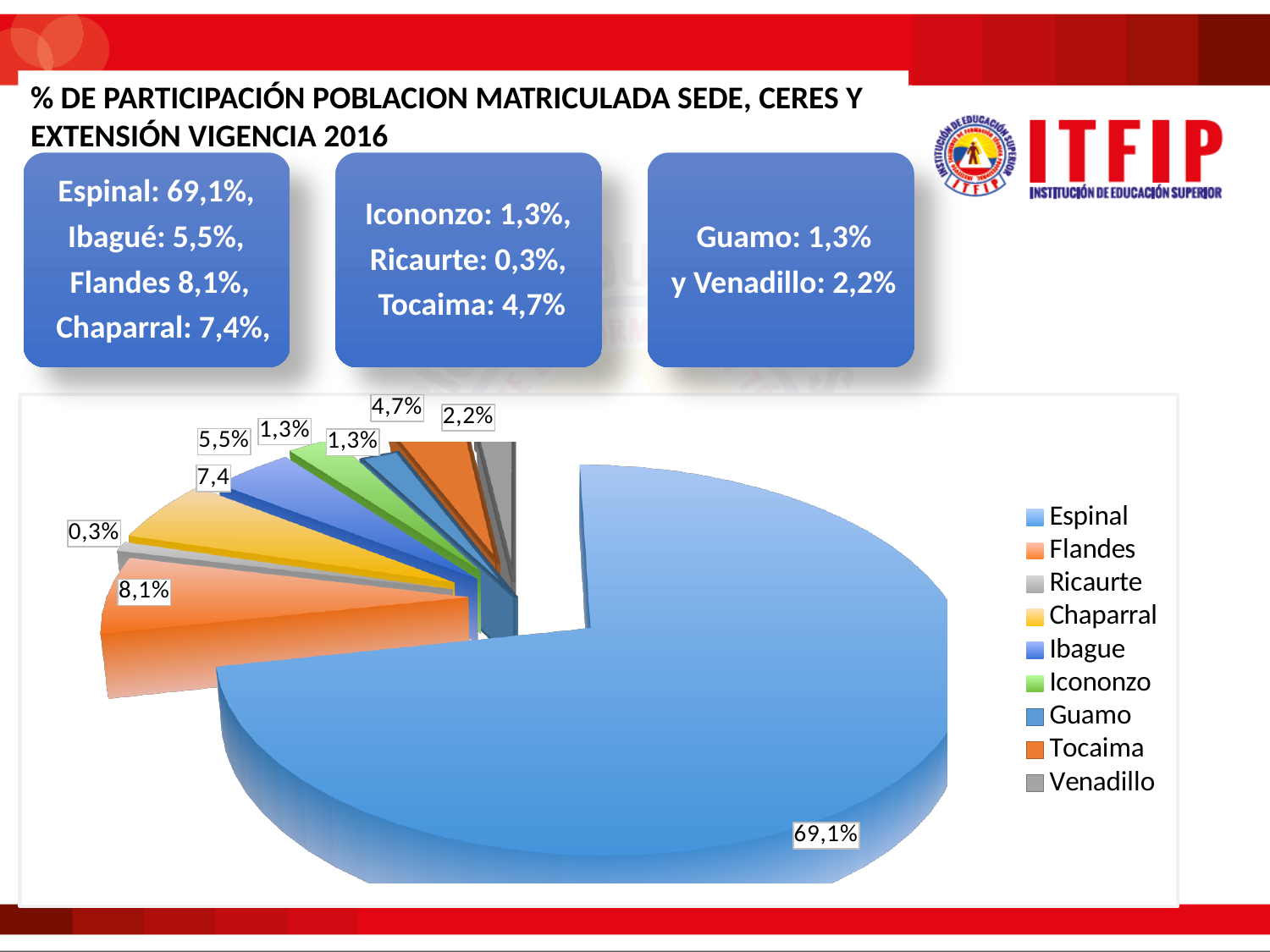
What is the value shown for Tocaima? 4,7% What kind of chart is shown on the slide? pie chart Which is larger, the value for Ibague or the value for Tocaima? Ibague What is the value shown for Venadillo? 2,2% What is the value shown for Ricaurte? 0,3% What is the difference between the values for Flandes and Chaparral? 0,7% Which category has the largest slice of the pie? Espinal How many entries does the legend of the pie chart list? 9 What is the value shown for Flandes? 8,1% What share of the pie does Espinal have? 69,1% How many slices does the pie chart have? 9 Which category has the smallest slice of the pie? Ricaurte